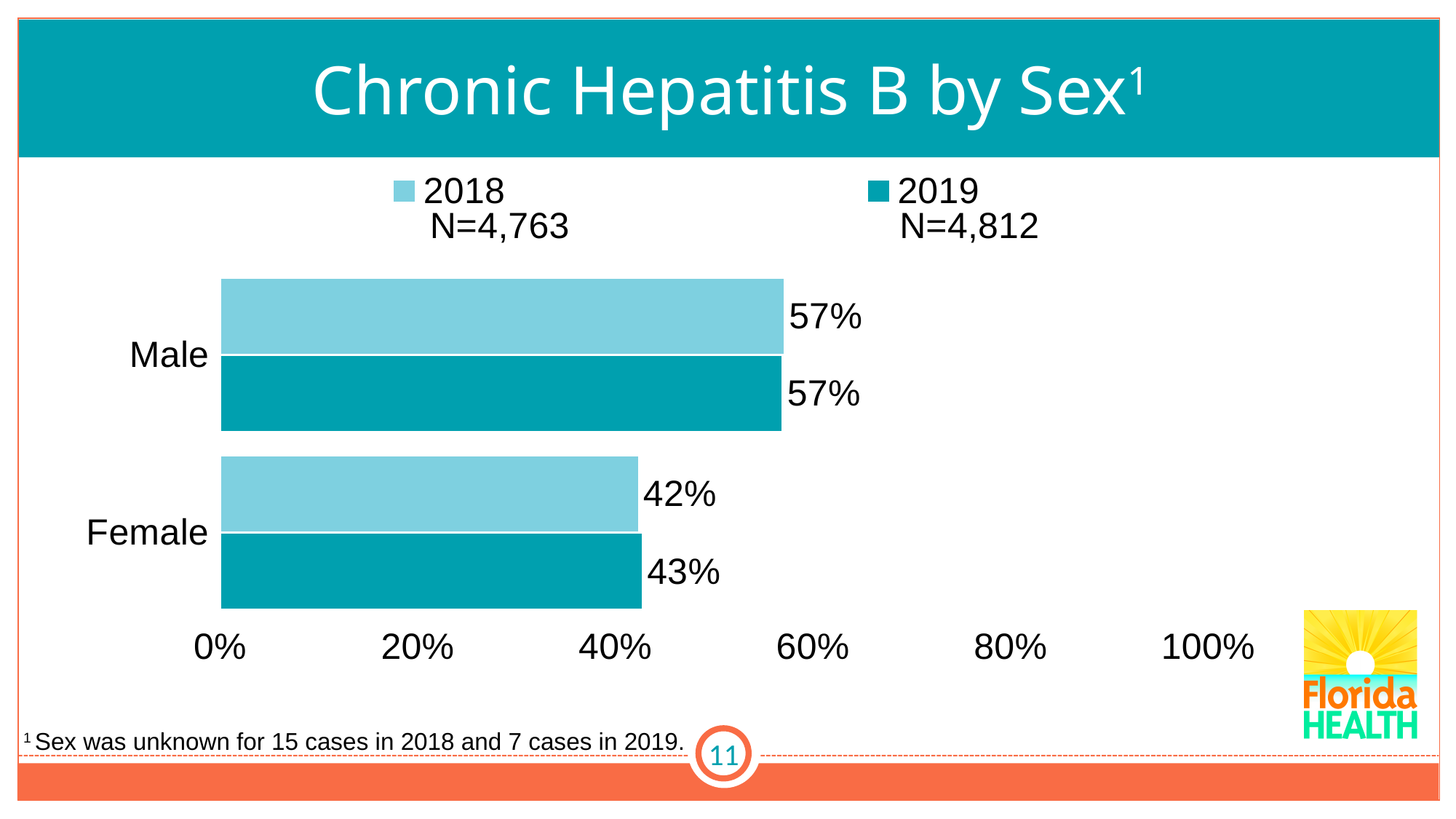
What percentage of chronic hepatitis B cases were Male in 2019? 57% What percentage of chronic hepatitis B cases were Female in 2019? 43% How many series does the legend list? 2 Which sex category had the lowest percentage of cases in 2018? Female What is the N value shown in the legend for 2019? N=4,812 What is the difference between the Male and Female percentages in 2018? 15% What percentage of chronic hepatitis B cases were Female in 2018? 42% Which sex category had the higher percentage of cases in 2019? Male What kind of chart is shown on the slide? Bar chart What percentage of chronic hepatitis B cases were Male in 2018? 57% What is the difference between the Female percentages in 2019 and 2018? 1% Is the Male percentage in 2019 greater or less than 40%? greater